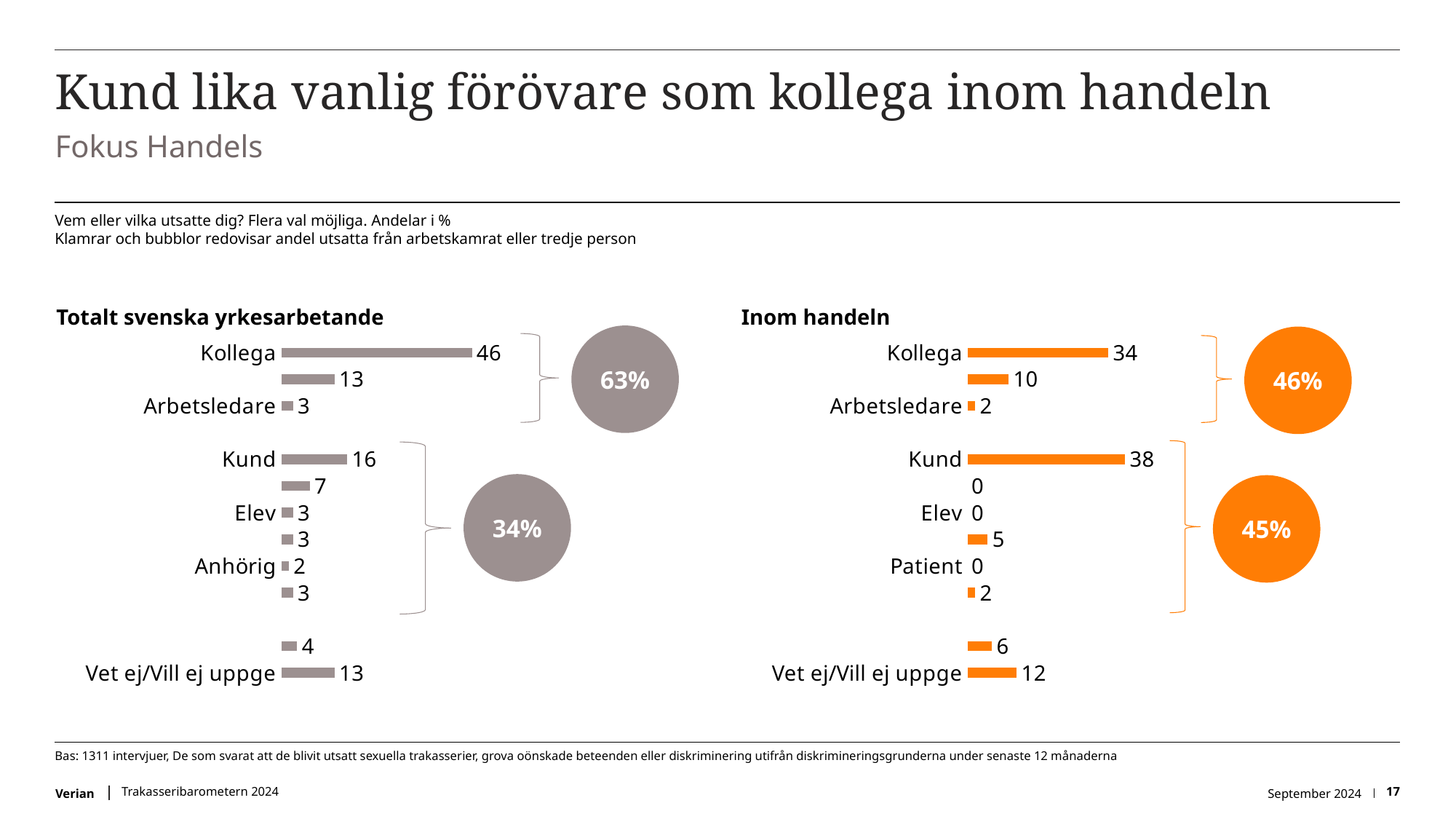
What is the difference between the value for Kollega in the 'Totalt svenska yrkesarbetande' chart and the value for Kollega in the 'Inom handeln' chart? 12 What kind of chart is the 'Inom handeln' chart? Bar chart In the 'Inom handeln' chart, what is the value for Kund? 38 In the 'Inom handeln' chart, which category has the highest value? Kund In the 'Totalt svenska yrkesarbetande' chart, what is the value for Vet ej/Vill ej uppge? 13 In the 'Inom handeln' chart, what is the difference between the values for Kund and Kollega? 4 In the 'Totalt svenska yrkesarbetande' chart, what is the value for Kollega? 46 In the 'Totalt svenska yrkesarbetande' chart, what percentage is shown in the bubble next to the Kund/Elev/Anhörig group? 34% In the 'Totalt svenska yrkesarbetande' chart, which category has the highest value? Kollega In the 'Totalt svenska yrkesarbetande' chart, which is larger, the value for Kollega or the value for Kund? Kollega In the 'Inom handeln' chart, what percentage is shown in the upper bubble next to the Kollega/Arbetsledare group? 46% In the 'Inom handeln' chart, what is the value for Elev? 0